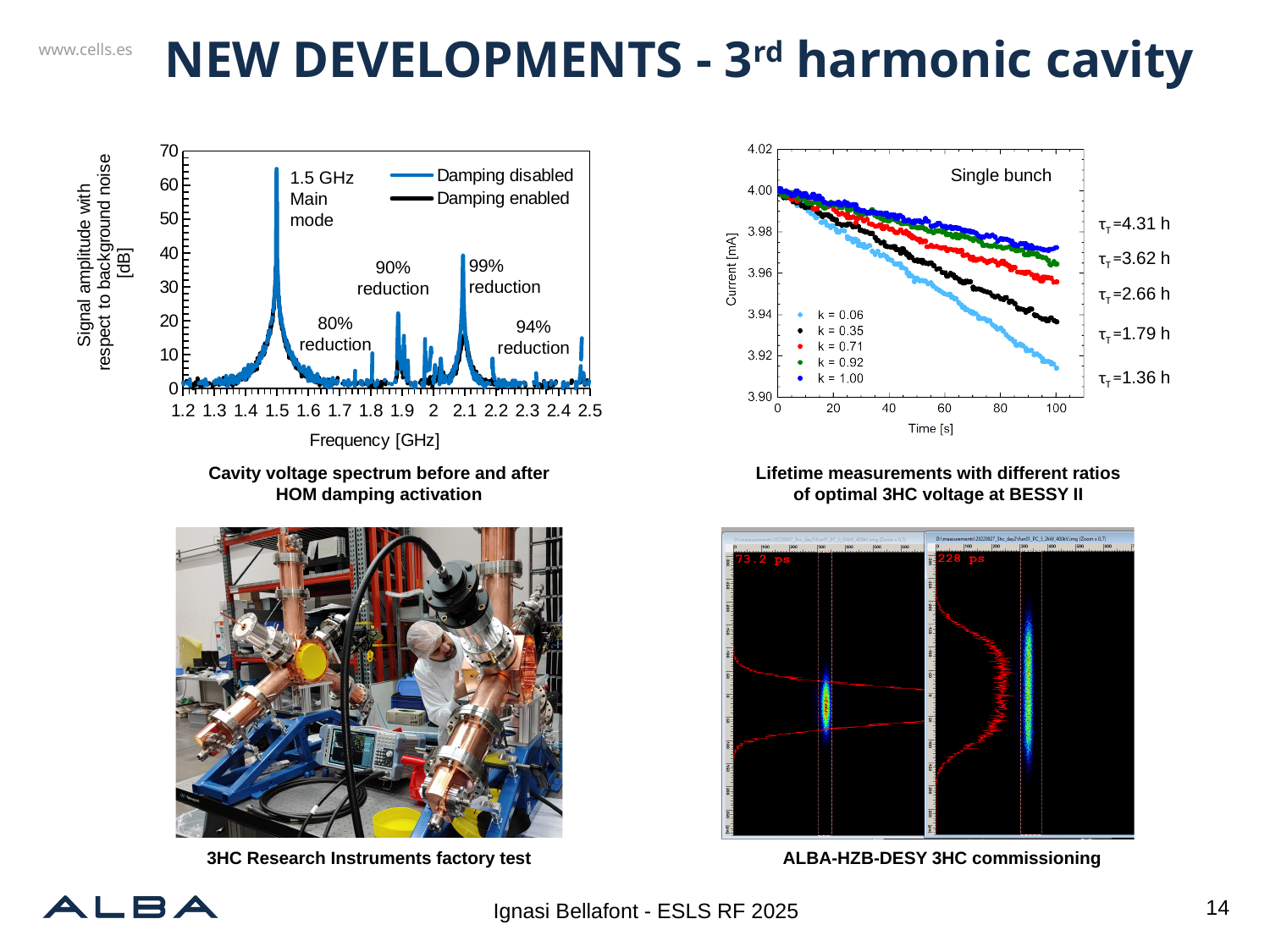
In the 'Lifetime measurements with different ratios of optimal 3HC voltage at BESSY II' chart, how many k values does the legend list? 5 In the 'Cavity voltage spectrum before and after HOM damping activation' chart, what are the two legend entries? Damping disabled, Damping enabled In the 'Cavity voltage spectrum before and after HOM damping activation' chart, what is the largest reduction percentage annotated? 99% In the 'Lifetime measurements with different ratios of optimal 3HC voltage at BESSY II' chart, what is the longest lifetime shown? 4.31 h In the 'Lifetime measurements with different ratios of optimal 3HC voltage at BESSY II' chart, what is the shortest lifetime shown? 1.36 h In the 'Cavity voltage spectrum before and after HOM damping activation' chart, what is the label of the x axis? Frequency [GHz] In the 'Cavity voltage spectrum before and after HOM damping activation' chart, is the peak of the main mode at 1.5 GHz greater or less than 60 dB? greater In the 'Lifetime measurements with different ratios of optimal 3HC voltage at BESSY II' chart, does the current rise or fall as time increases? fall In the 'Cavity voltage spectrum before and after HOM damping activation' chart, how many series does the legend list? 2 In the 'Cavity voltage spectrum before and after HOM damping activation' chart, at what frequency is the main mode annotated? 1.5 GHz In the 'Cavity voltage spectrum before and after HOM damping activation' chart, what is the smallest reduction percentage annotated? 80% In the 'Lifetime measurements with different ratios of optimal 3HC voltage at BESSY II' chart, what is the difference between the longest and shortest lifetimes shown? 2.95 h